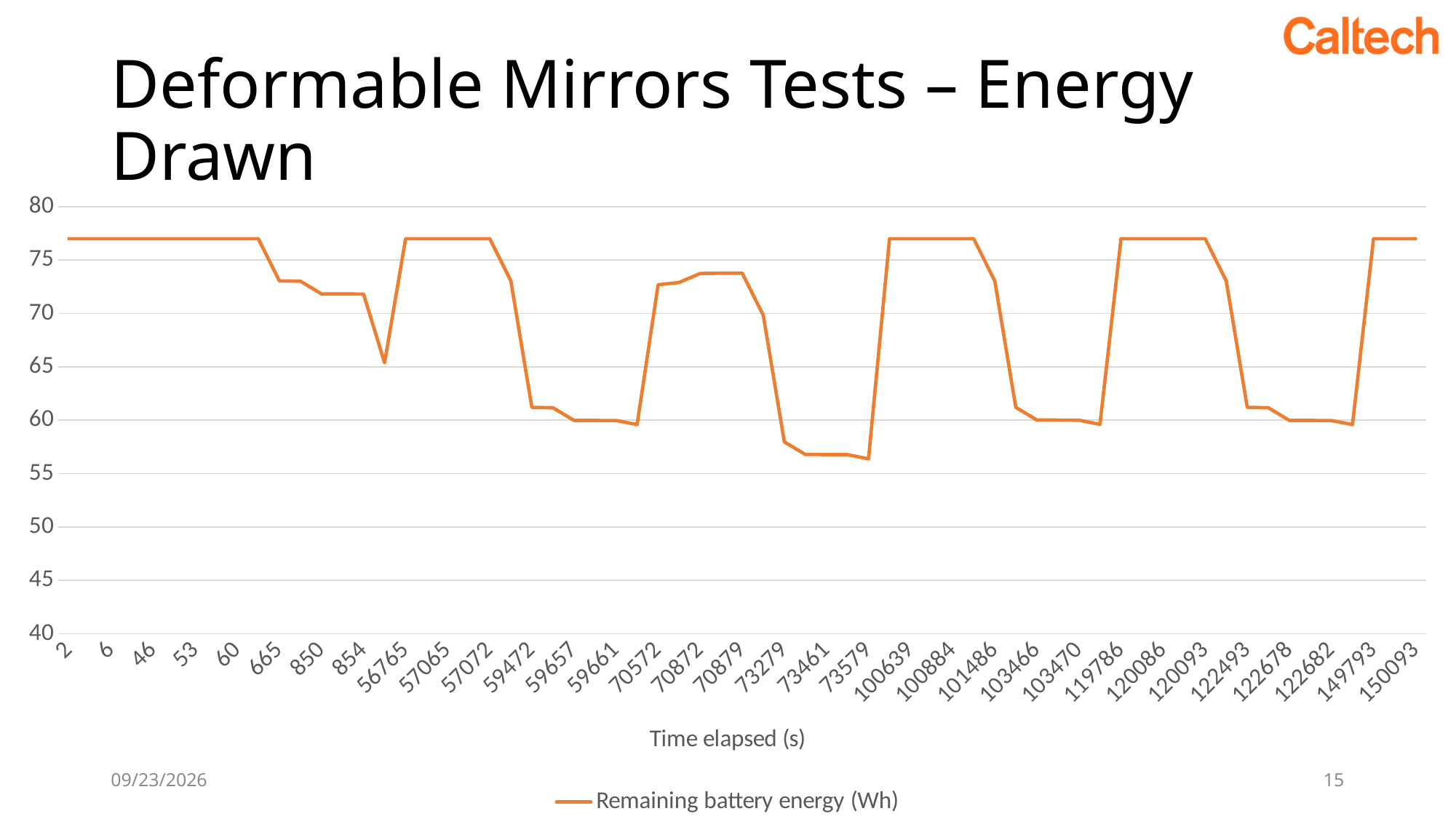
Is the value for time 73461 greater or less than 60? less What is the title of the x axis? Time elapsed (s) Is the value for time 665 greater or less than 70? greater Is the value for time 100639 greater or less than 75? greater Which is larger, the value for time 2 or the value for time 73579? time 2 What kind of chart is shown on the slide? line chart How many series does the legend list? 1 Which is larger, the value for time 57065 or the value for time 59661? time 57065 What is the name of the series shown in the legend? Remaining battery energy (Wh)